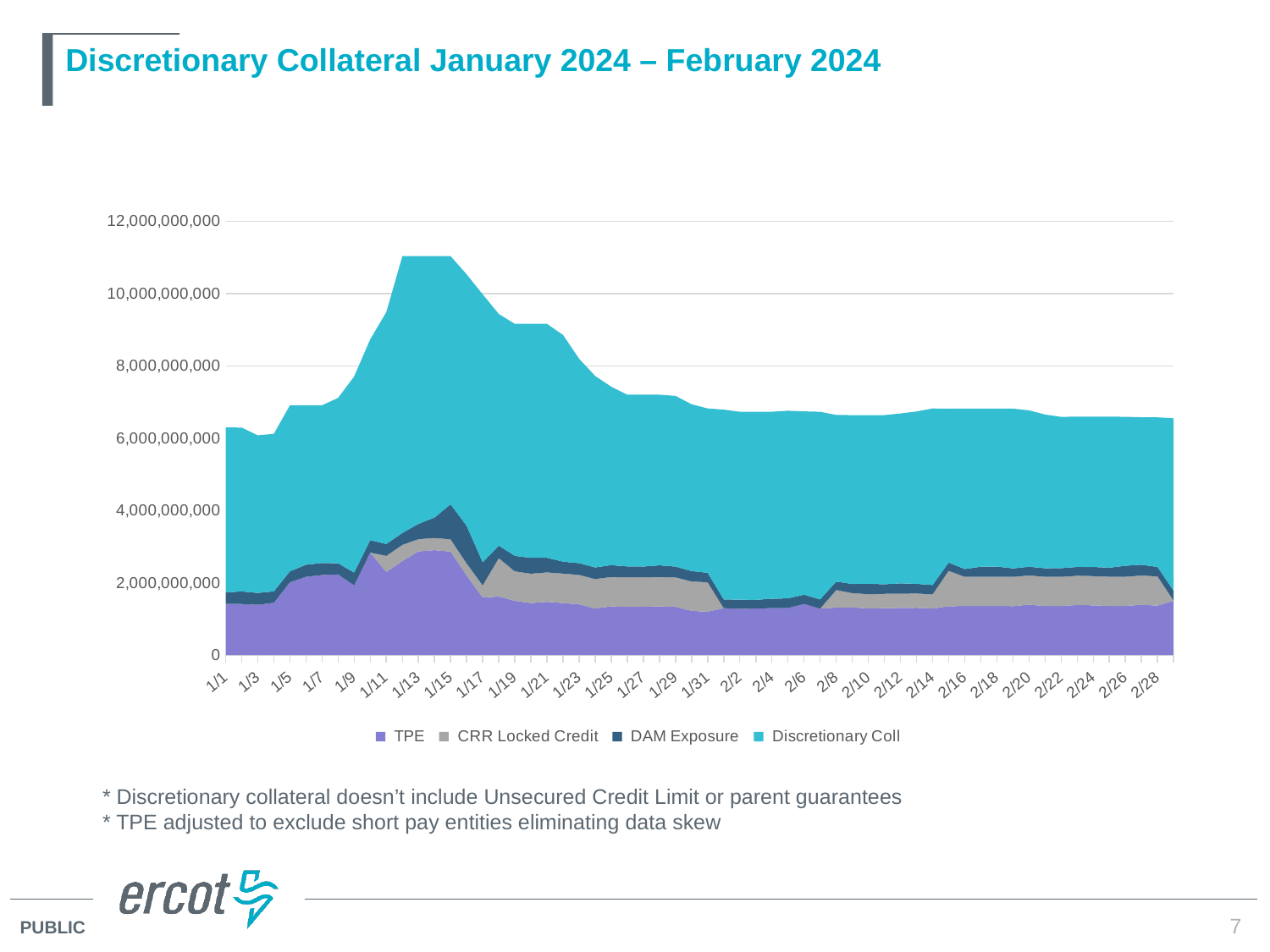
Which series is plotted at the bottom of the stack? TPE How many series does the legend list? 4 Is the total stacked value on 2/28 greater or less than 8,000,000,000? less What is the title of the slide's chart? Discretionary Collateral January 2024 – February 2024 Does the total stacked value rise or fall between 1/5 and 1/13? Rise Does the total stacked value rise or fall between 1/15 and 1/23? Fall What kind of chart is shown on the slide? Stacked area chart Which is larger, the total stacked value on 1/13 or on 2/28? 1/13 How many date labels are shown on the x axis? 30 Is the total stacked value on 1/21 greater or less than 8,000,000,000? greater Is the total stacked value on 1/13 greater or less than 10,000,000,000? greater